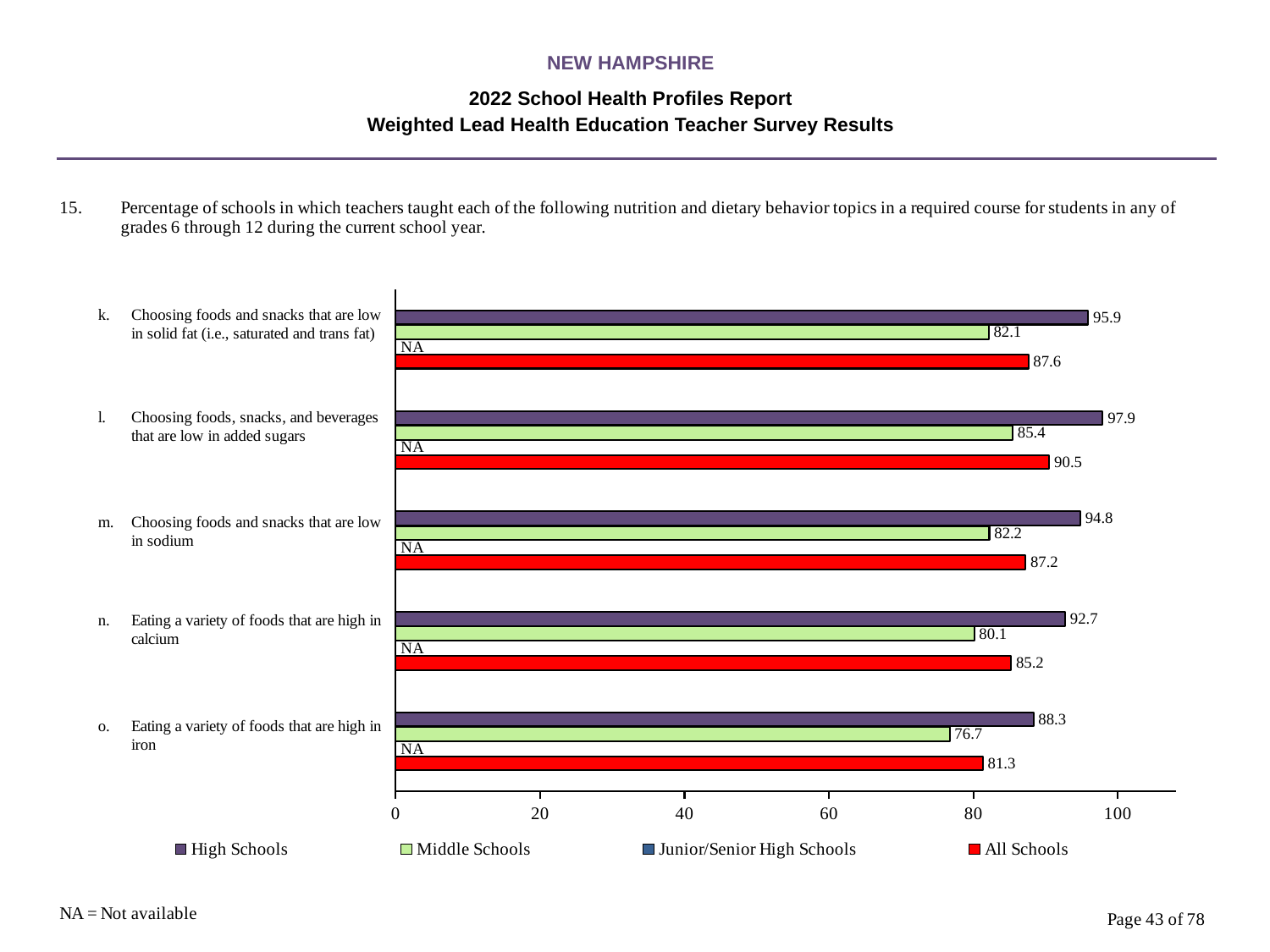
What is the difference between the High Schools and Middle Schools values for 'Choosing foods and snacks that are low in solid fat'? 13.8 Which is larger: the All Schools value for 'Eating a variety of foods that are high in calcium' or the All Schools value for 'Eating a variety of foods that are high in iron'? Eating a variety of foods that are high in calcium How many topics (categories) are shown on the chart? 5 What is the value for High Schools for 'Choosing foods, snacks, and beverages that are low in added sugars'? 97.9 What is shown for Junior/Senior High Schools for 'Eating a variety of foods that are high in calcium'? NA How many series does the legend list? 4 What is the value for All Schools for 'Choosing foods and snacks that are low in sodium'? 87.2 Is the Middle Schools value for 'Eating a variety of foods that are high in iron' greater or less than 80? less Which topic has the lowest value for All Schools? Eating a variety of foods that are high in iron Which topic has the highest value for High Schools? Choosing foods, snacks, and beverages that are low in added sugars What kind of chart is shown on the slide? bar chart What is the value for Middle Schools for 'Eating a variety of foods that are high in iron'? 76.7